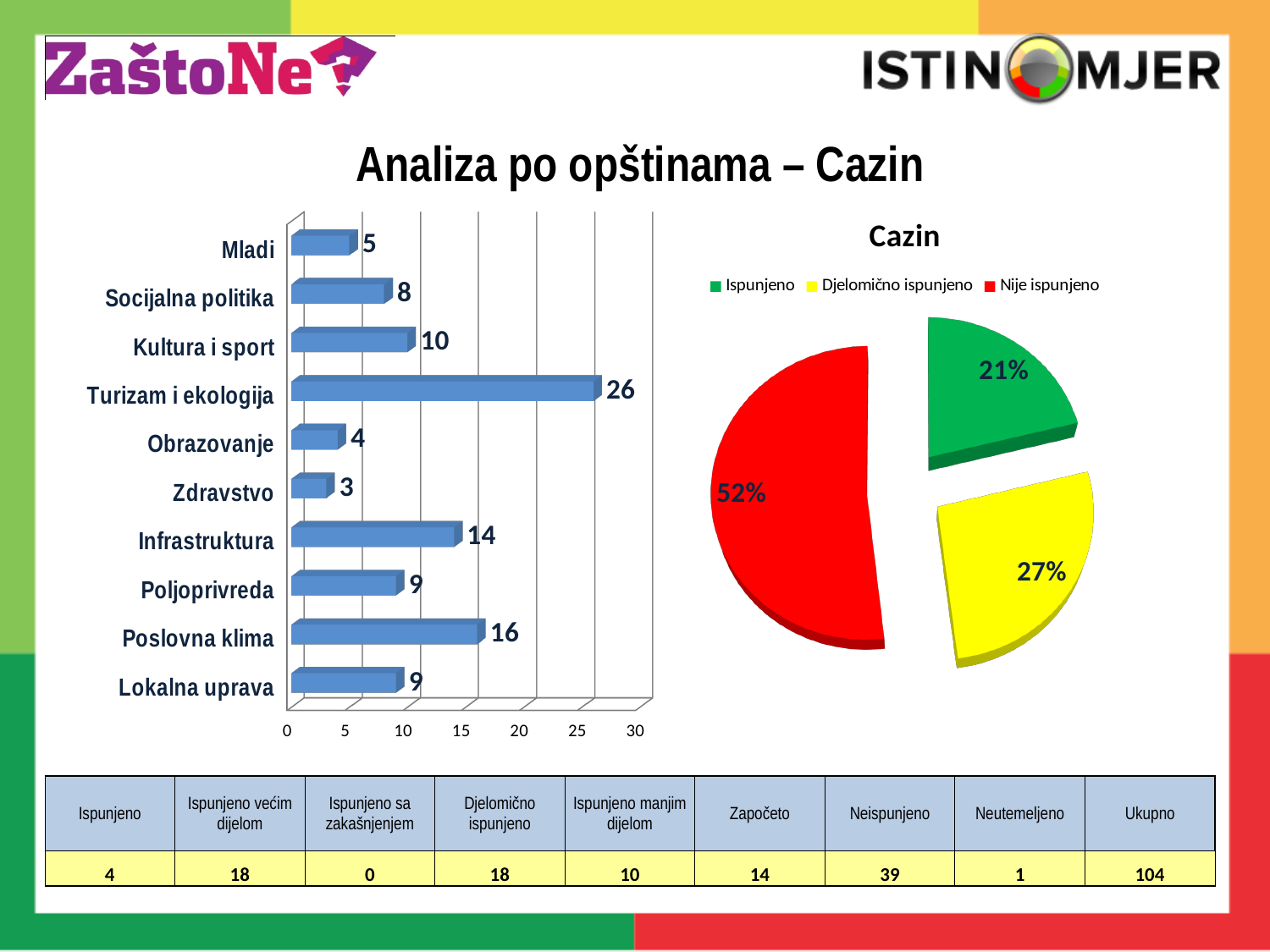
In the bar chart on the left, which category has the highest value? Turizam i ekologija In the bar chart on the left, which category has the lowest value? Zdravstvo In the bar chart on the left, what is the value for Infrastruktura? 14 In the bar chart on the left, which is larger, Kultura i sport or Mladi? Kultura i sport In the pie chart titled Cazin, which slice is the largest? Nije ispunjeno In the pie chart titled Cazin, what share is Nije ispunjeno? 52% In the bar chart on the left, what is the value for Turizam i ekologija? 26 In the pie chart titled Cazin, what share is Ispunjeno? 21% How many entries does the legend of the pie chart titled Cazin list? 3 How many categories does the bar chart on the left show? 10 In the bar chart on the left, what is the difference between Poslovna klima and Socijalna politika? 8 What kind of chart is the chart on the left? bar chart